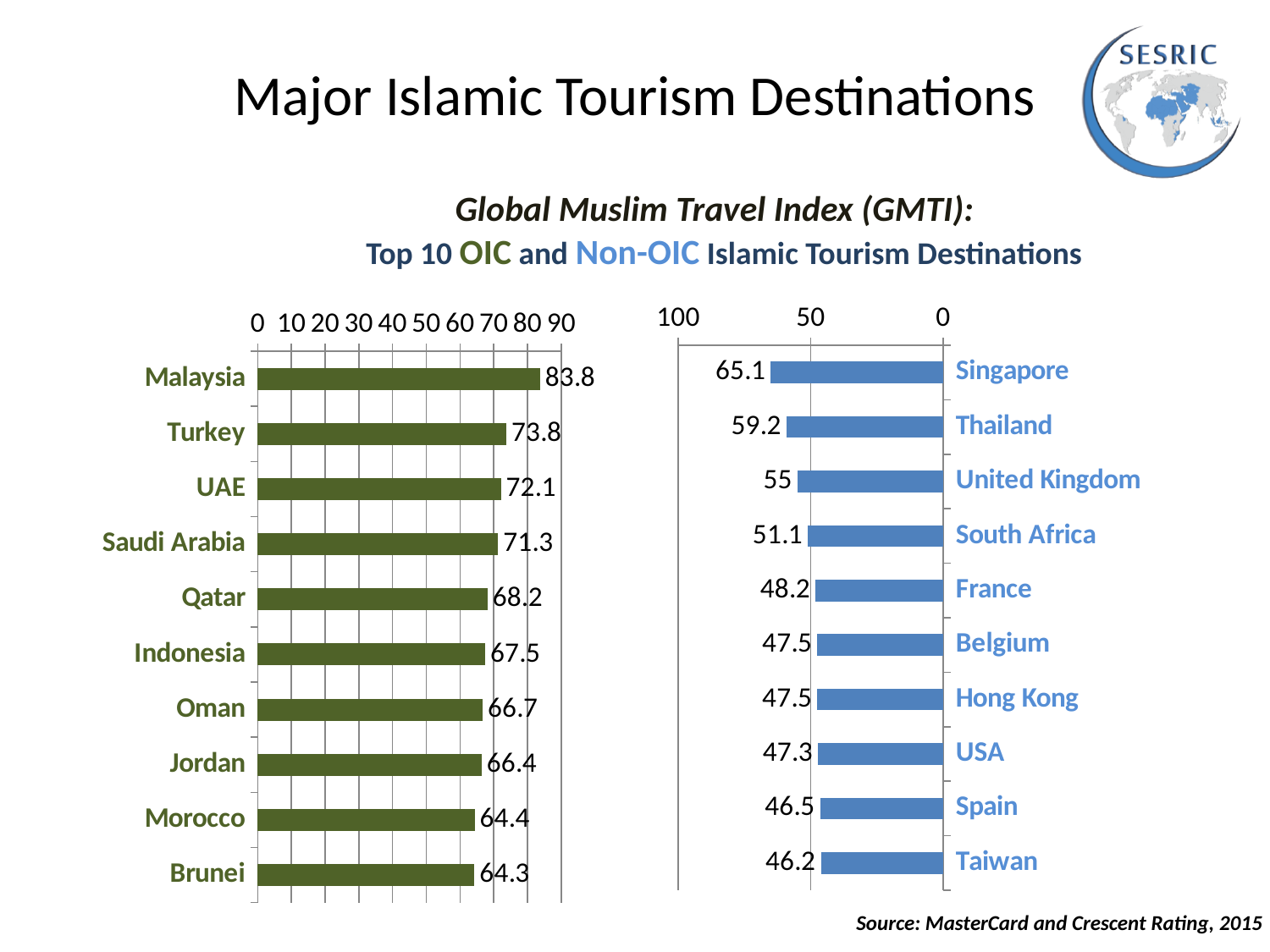
In the left (OIC) chart, which country has the lowest value? Brunei In the right (Non-OIC) chart, what is the GMTI value for Thailand? 59.2 In the right (Non-OIC) chart, which country has the highest value? Singapore In the right (Non-OIC) chart, is the value for United Kingdom greater or less than 50? greater How many countries are shown in the left (OIC) chart? 10 In the left (OIC) chart, what is the difference between the values for Malaysia and Turkey? 10 In the left (OIC) chart, what is the GMTI value for Malaysia? 83.8 What type of chart is the right (Non-OIC) chart? Bar chart What colour are the bars in the left (OIC) chart? Green In the left (OIC) chart, which has a larger value, UAE or Qatar? UAE In the right (Non-OIC) chart, do the values rise or fall going from Singapore at the top to Taiwan at the bottom? Fall In the right (Non-OIC) chart, what is the difference between the values for Singapore and Taiwan? 18.9